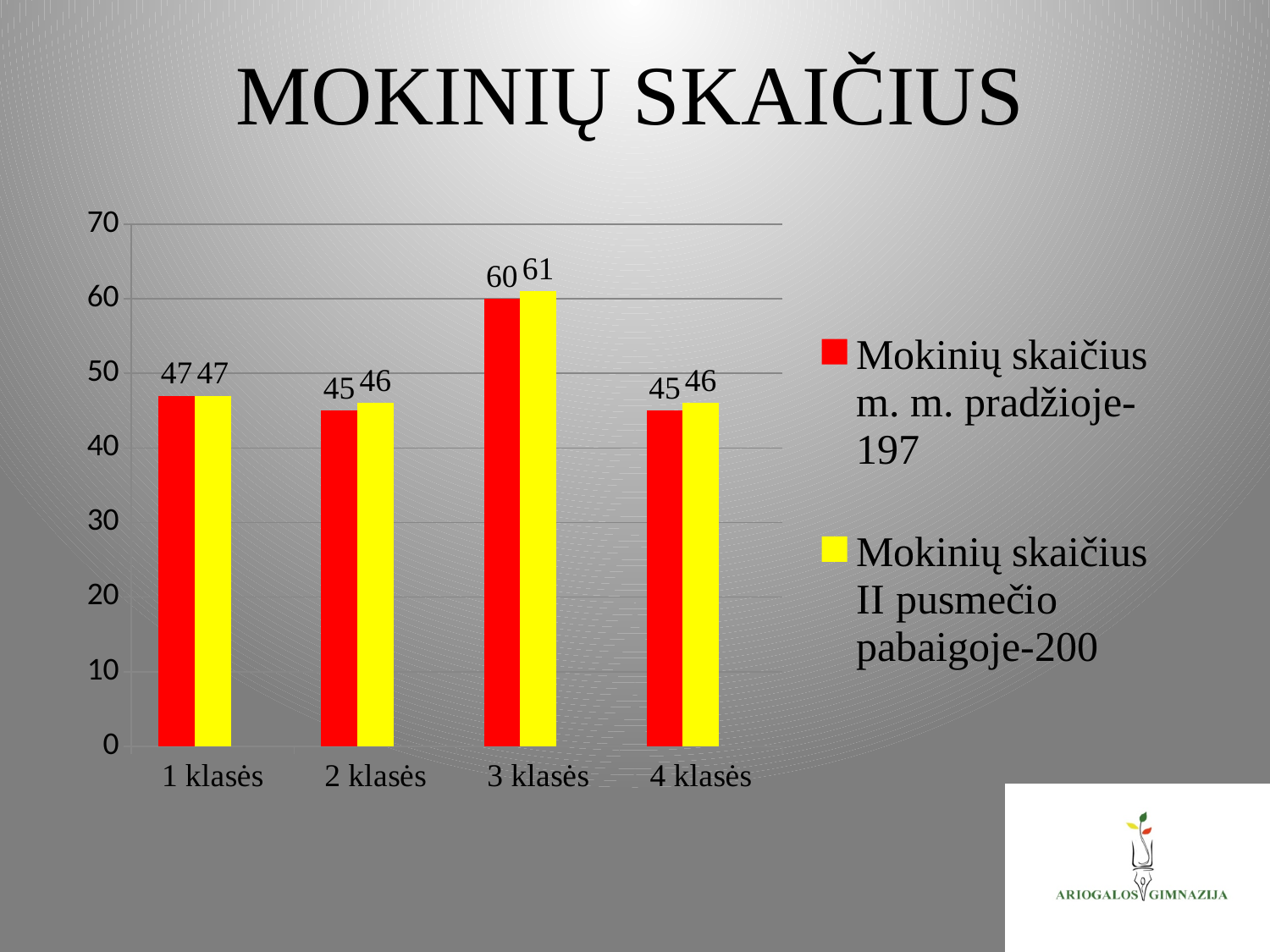
What is the value for 1 klasės in the 'Mokinių skaičius II pusmečio pabaigoje-200' series? 47 Is the value for 3 klasės in the 'Mokinių skaičius II pusmečio pabaigoje-200' series greater or less than 50? greater Which category has the highest value in the 'Mokinių skaičius m. m. pradžioje-197' series? 3 klasės How many categories are shown on the x axis? 4 Which category has the lowest value in the 'Mokinių skaičius II pusmečio pabaigoje-200' series? 2 klasės and 4 klasės (tied at 46) What is the difference between the 'Mokinių skaičius m. m. pradžioje-197' values for 3 klasės and 4 klasės? 15 What is the value for 3 klasės in the 'Mokinių skaičius m. m. pradžioje-197' series? 60 What is the difference between the two series for 3 klasės? 1 How many series does the legend list? 2 Which is larger: the 'Mokinių skaičius m. m. pradžioje-197' value for 1 klasės or for 2 klasės? 1 klasės What kind of chart is shown on the slide? bar chart What is the value for 2 klasės in the 'Mokinių skaičius II pusmečio pabaigoje-200' series? 46